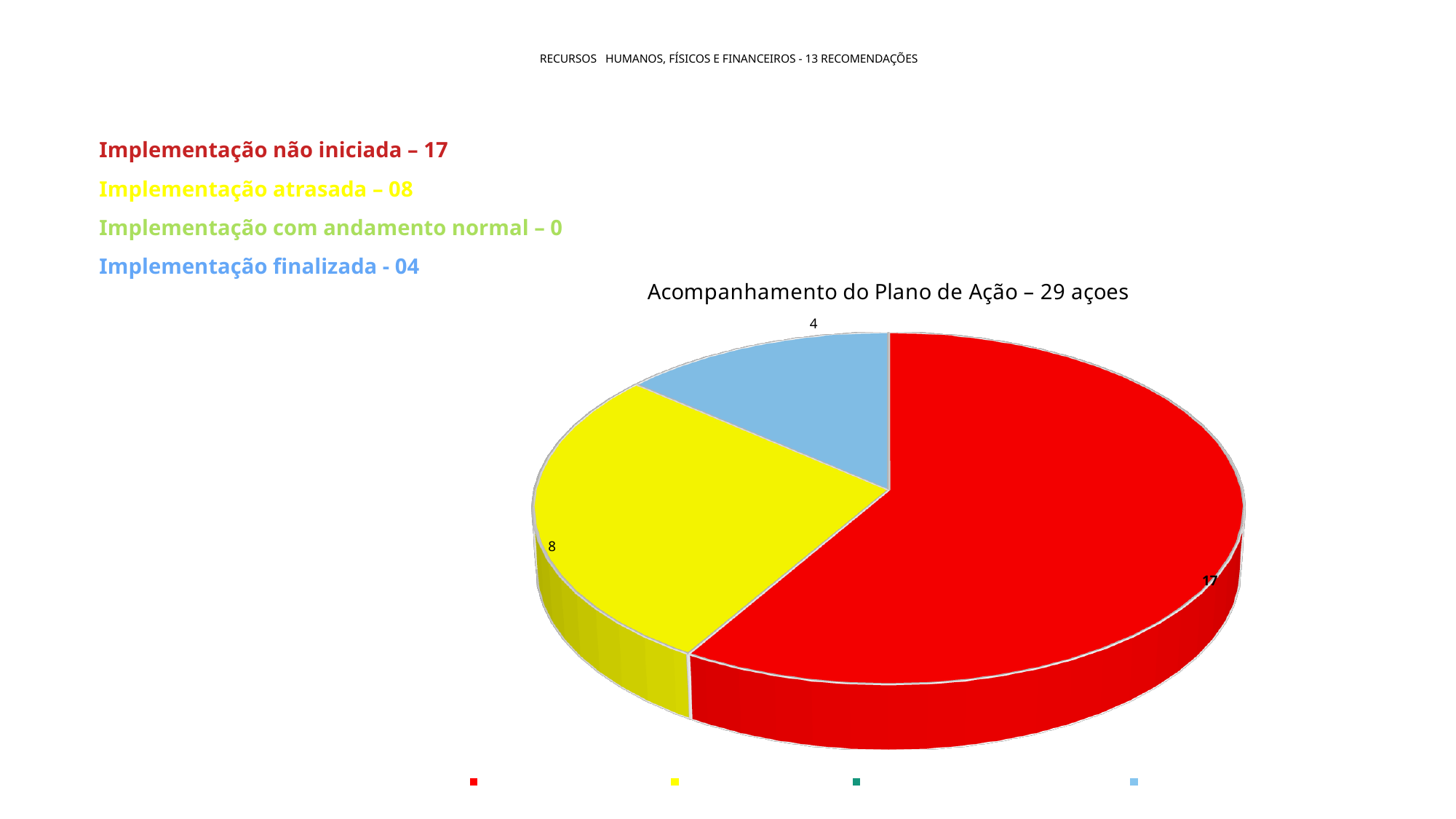
Which is larger, the yellow slice or the light blue slice? the yellow slice How many slices with data labels are visible in the pie chart? 3 What is the title of the chart? Acompanhamento do Plano de Ação – 29 açoes What value is shown on the light blue slice of the pie chart? 4 How many colour swatches does the legend below the chart show? 4 Which slice of the pie chart has the largest value? the red slice (17) What is the difference between the yellow slice value and the light blue slice value? 4 What kind of chart is shown on the slide? pie chart What value is shown on the red slice of the pie chart? 17 Which visible slice of the pie chart has the smallest value? the light blue slice (4) What is the difference between the red slice value and the yellow slice value? 9 What value is shown on the yellow slice of the pie chart? 8